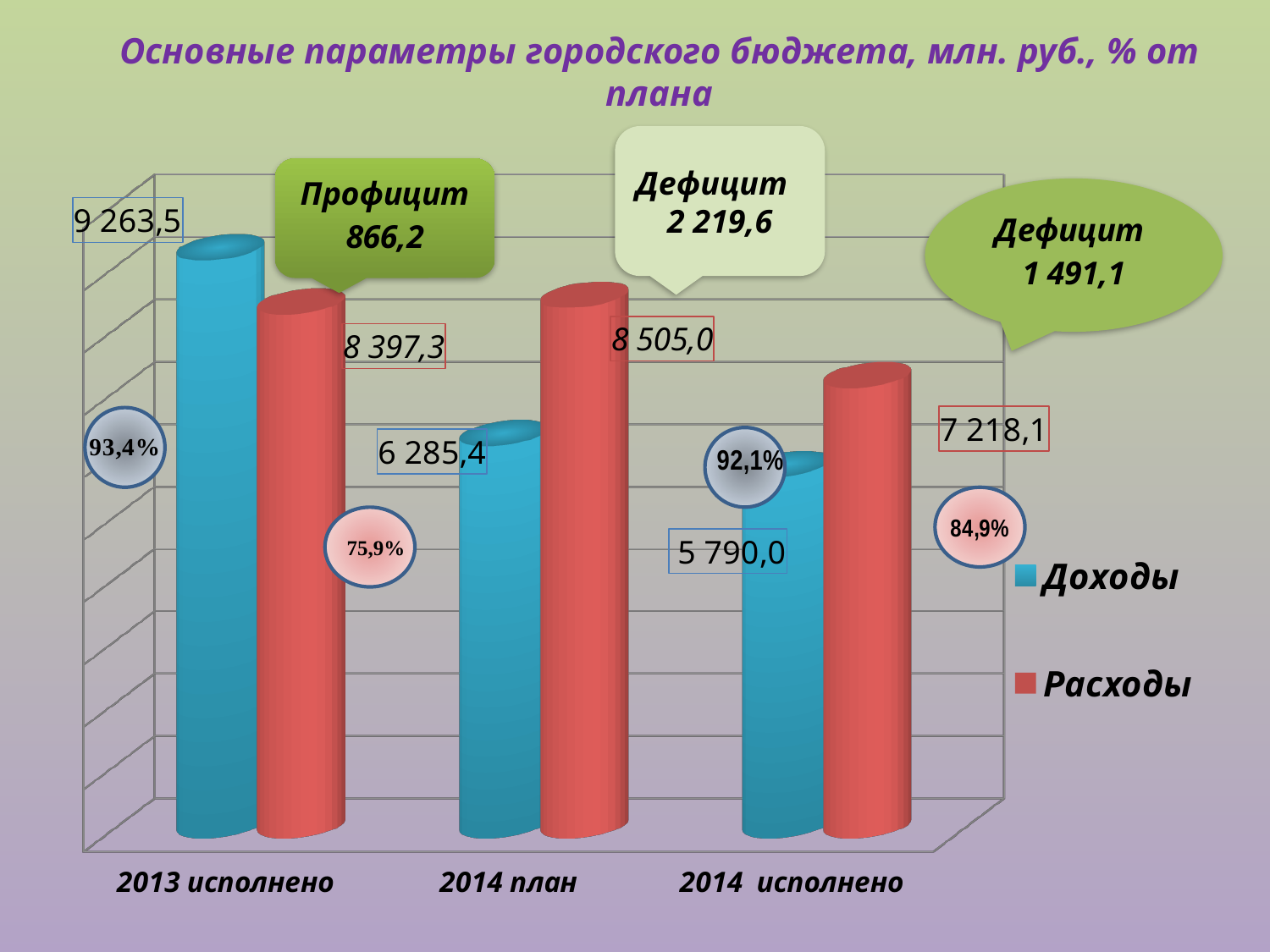
How many categories are shown on the x axis? 3 What kind of chart is shown on the slide? Bar chart What is the value of Расходы for 2014 исполнено? 7 218,1 What is the value of Доходы for 2014 исполнено? 5 790,0 What is the value of Расходы for 2014 план? 8 505,0 How many series does the legend list? 2 Which category has the lowest value for Расходы? 2014 исполнено What is the difference between Доходы and Расходы for 2013 исполнено? 866,2 What is the value of Доходы for 2013 исполнено? 9 263,5 Which is larger for 2014 план, Доходы or Расходы? Расходы What is the difference between Расходы and Доходы for 2014 план? 2 219,6 Which category has the highest value for Доходы? 2013 исполнено